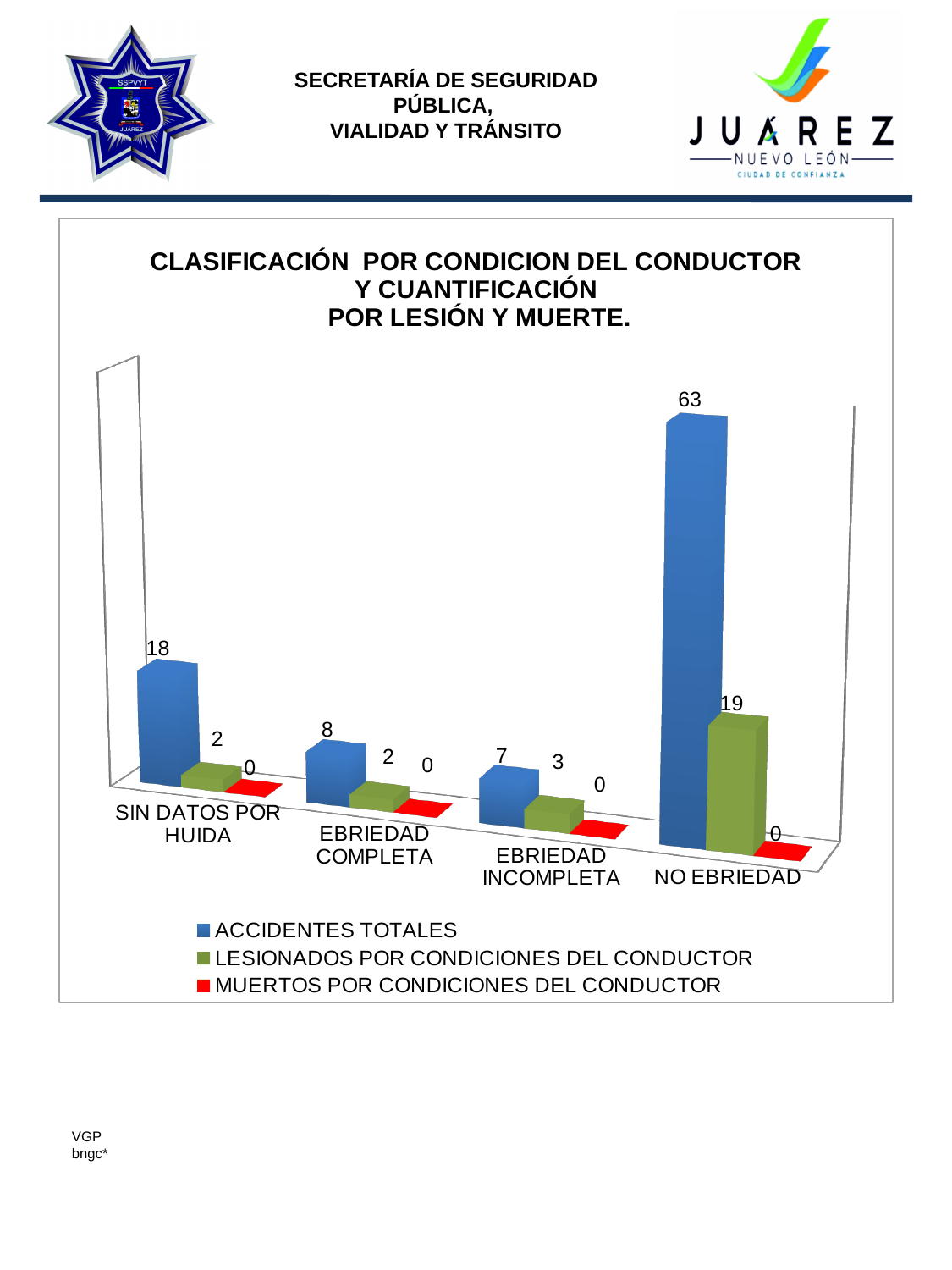
What is the value of MUERTOS POR CONDICIONES DEL CONDUCTOR for EBRIEDAD COMPLETA? 0 Which category has the lowest value for ACCIDENTES TOTALES? EBRIEDAD INCOMPLETA What is the difference between ACCIDENTES TOTALES for NO EBRIEDAD and for SIN DATOS POR HUIDA? 45 How many categories are shown on the x axis? 4 What is the value of ACCIDENTES TOTALES for SIN DATOS POR HUIDA? 18 What colour represents MUERTOS POR CONDICIONES DEL CONDUCTOR in the legend? Red Which is larger: LESIONADOS POR CONDICIONES DEL CONDUCTOR for NO EBRIEDAD or for EBRIEDAD INCOMPLETA? NO EBRIEDAD Which category has the highest value for ACCIDENTES TOTALES? NO EBRIEDAD What is the value of LESIONADOS POR CONDICIONES DEL CONDUCTOR for EBRIEDAD INCOMPLETA? 3 What kind of chart is shown on the slide? Bar chart What is the value of ACCIDENTES TOTALES for NO EBRIEDAD? 63 How many series does the legend list? 3